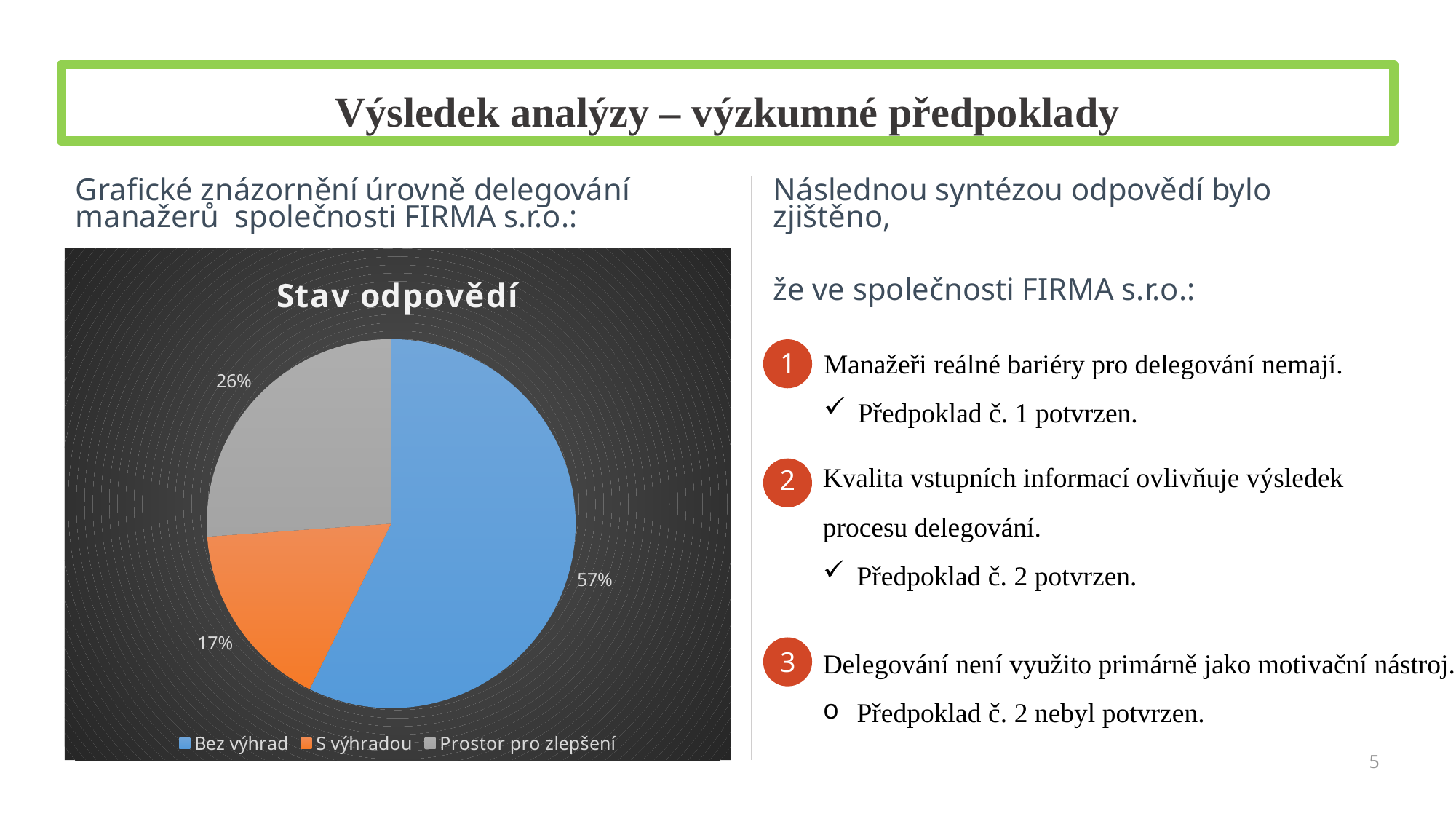
Which is larger, the share for 'Prostor pro zlepšení' or the share for 'S výhradou'? Prostor pro zlepšení What is the combined share of 'S výhradou' and 'Prostor pro zlepšení'? 43% What type of chart is shown on the slide? pie chart What is the title of the chart? Stav odpovědí How many categories does the pie chart show? 3 Which category has the largest share of the pie? Bez výhrad Which category has the smallest share of the pie? S výhradou What colour is the 'S výhradou' slice? orange What share of the pie does 'Prostor pro zlepšení' represent? 26% What share of the pie does 'S výhradou' represent? 17% What is the difference in percentage points between 'Bez výhrad' and 'Prostor pro zlepšení'? 31 What share of the pie does 'Bez výhrad' represent? 57%